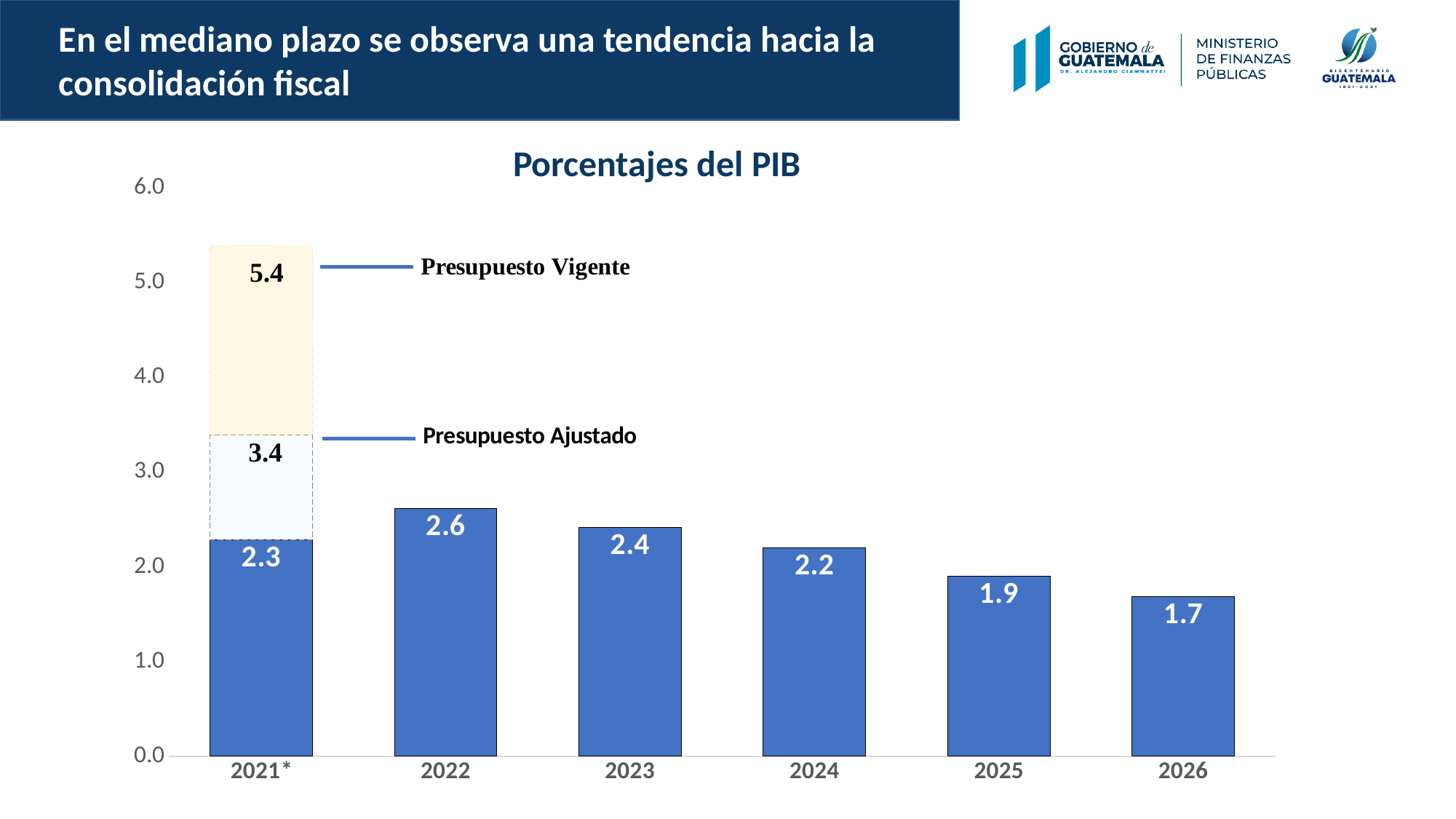
What kind of chart is the 'Porcentajes del PIB' chart? Bar chart In the 'Porcentajes del PIB' chart, what is the difference between the blue bar values for 2022 and 2026? 0.9 From 2022 to 2026, do the blue bar values in the 'Porcentajes del PIB' chart rise or fall? Fall What is the value of the blue bar for 2026 in the 'Porcentajes del PIB' chart? 1.7 Among the blue bars in the 'Porcentajes del PIB' chart, which year has the highest value? 2022 What is the value of the blue bar for 2022 in the 'Porcentajes del PIB' chart? 2.6 How many years are shown on the x axis of the 'Porcentajes del PIB' chart? 6 In the 'Porcentajes del PIB' chart, what is the difference between the 'Presupuesto Vigente' and 'Presupuesto Ajustado' values for 2021*? 2.0 In the 'Porcentajes del PIB' chart, which is larger: the blue bar for 2023 or the blue bar for 2025? 2023 What value is labelled for 'Presupuesto Vigente' in 2021* in the 'Porcentajes del PIB' chart? 5.4 Among the blue bars in the 'Porcentajes del PIB' chart, which year has the lowest value? 2026 What value is labelled for 'Presupuesto Ajustado' in 2021* in the 'Porcentajes del PIB' chart? 3.4